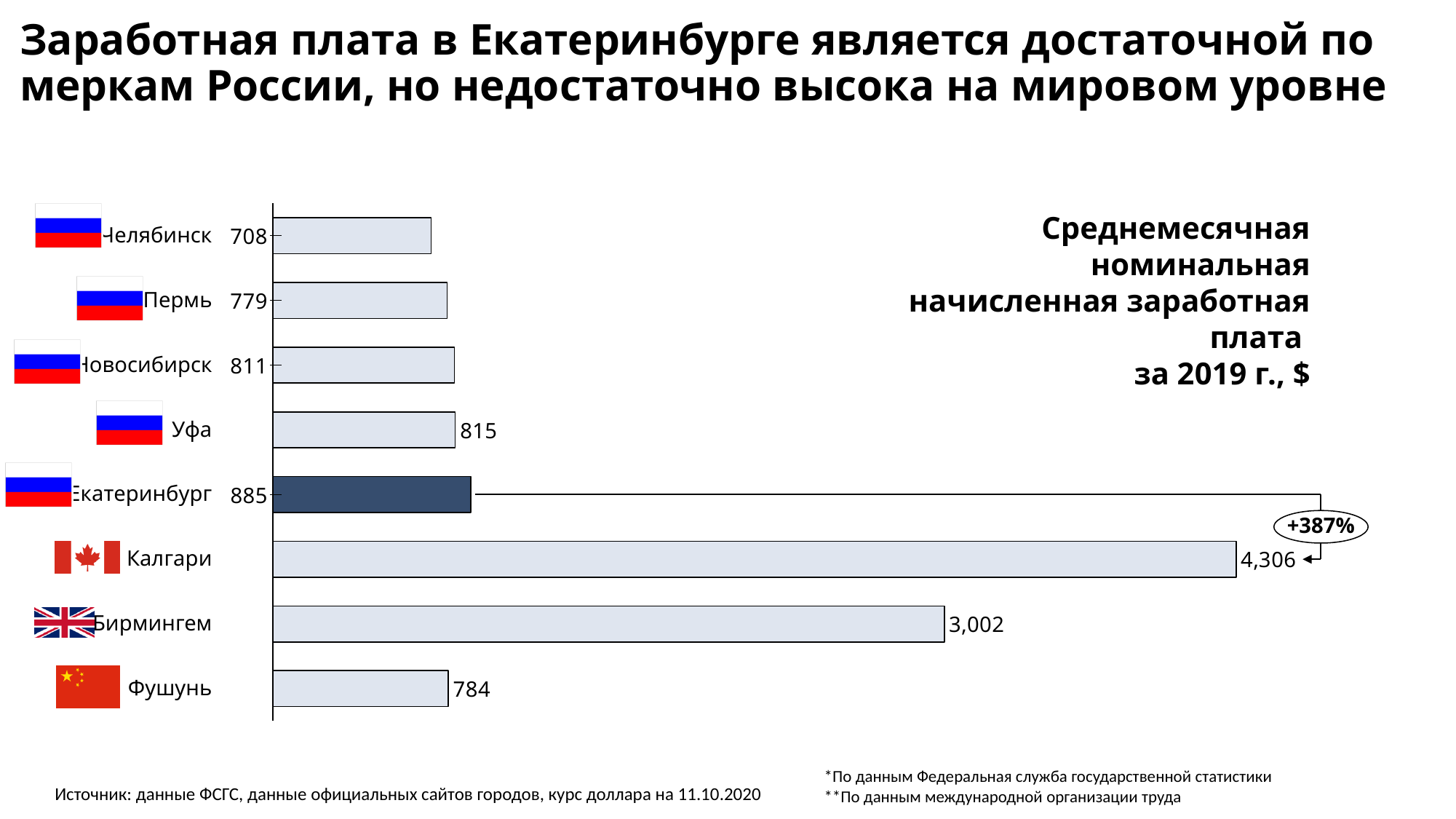
What is the value for Екатеринбург? 885 What is the difference between the values for Калгари and Бирмингем? 1,304 What is the difference between the values for Екатеринбург and Челябинск? 177 Which city has the lowest value? Челябинск How many cities are shown in the chart? 8 What is the value for Калгари? 4,306 What kind of chart is shown on the slide? Bar chart Which is larger, the value for Уфа or the value for Пермь? Уфа What percentage is shown in the callout between Екатеринбург and Калгари? +387% What is the value for Фушунь? 784 What is the value for Бирмингем? 3,002 Which city has the highest value? Калгари